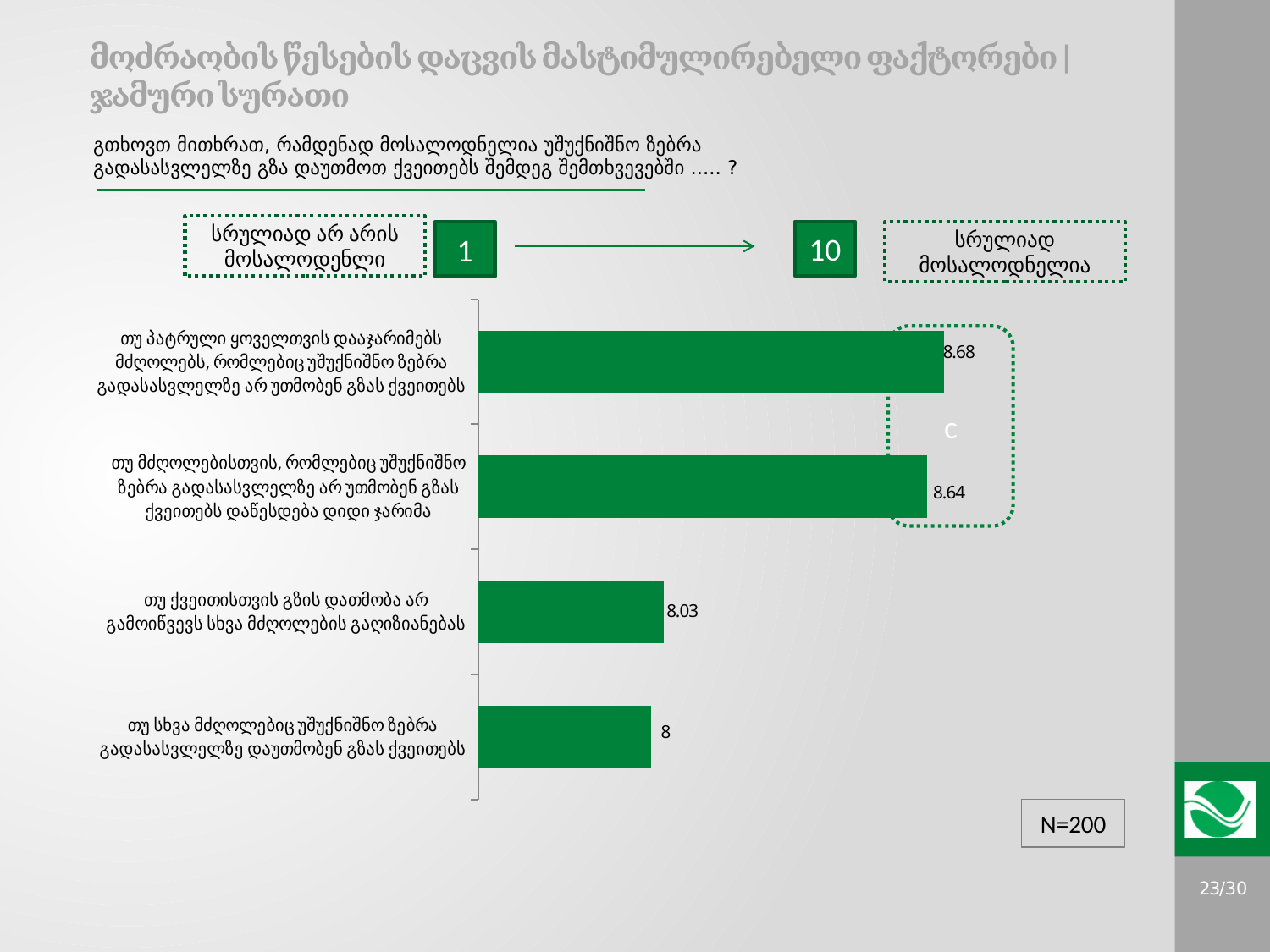
What is the value of the bottom bar (თუ სხვა მძღოლებიც უშუქნიშნო ზებრა გადასასვლელზე დაუთმობენ გზას ქვეითებს)? 8 How many bars (categories) does the chart show? 4 Which category has the lowest value? თუ სხვა მძღოლებიც უშუქნიშნო ზებრა გადასასვლელზე დაუთმობენ გზას ქვეითებს What type of chart is shown on the slide? bar chart What is the value of the third bar (თუ ქვეითისთვის გზის დათმობა არ გამოიწვევს სხვა მძღოლების გაღიზიანებას)? 8.03 What are the endpoints of the rating scale shown above the chart? 1 to 10 What is the value of the second bar from the top (თუ მძღოლებისთვის... დაწესდება დიდი ჯარიმა)? 8.64 Which is larger: the value for the second bar from the top or the value for the bottom bar? the second bar from the top (8.64) What is the difference between the top bar (8.68) and the third bar (8.03)? 0.65 What is the value of the top bar (თუ პატრული ყოველთვის დააჯარიმებს მძღოლებს...)? 8.68 What sample size (N) is stated on the slide? N=200 Which category has the highest value? თუ პატრული ყოველთვის დააჯარიმებს მძღოლებს, რომლებიც უშუქნიშნო ზებრა გადასასვლელზე არ უთმობენ გზას ქვეითებს